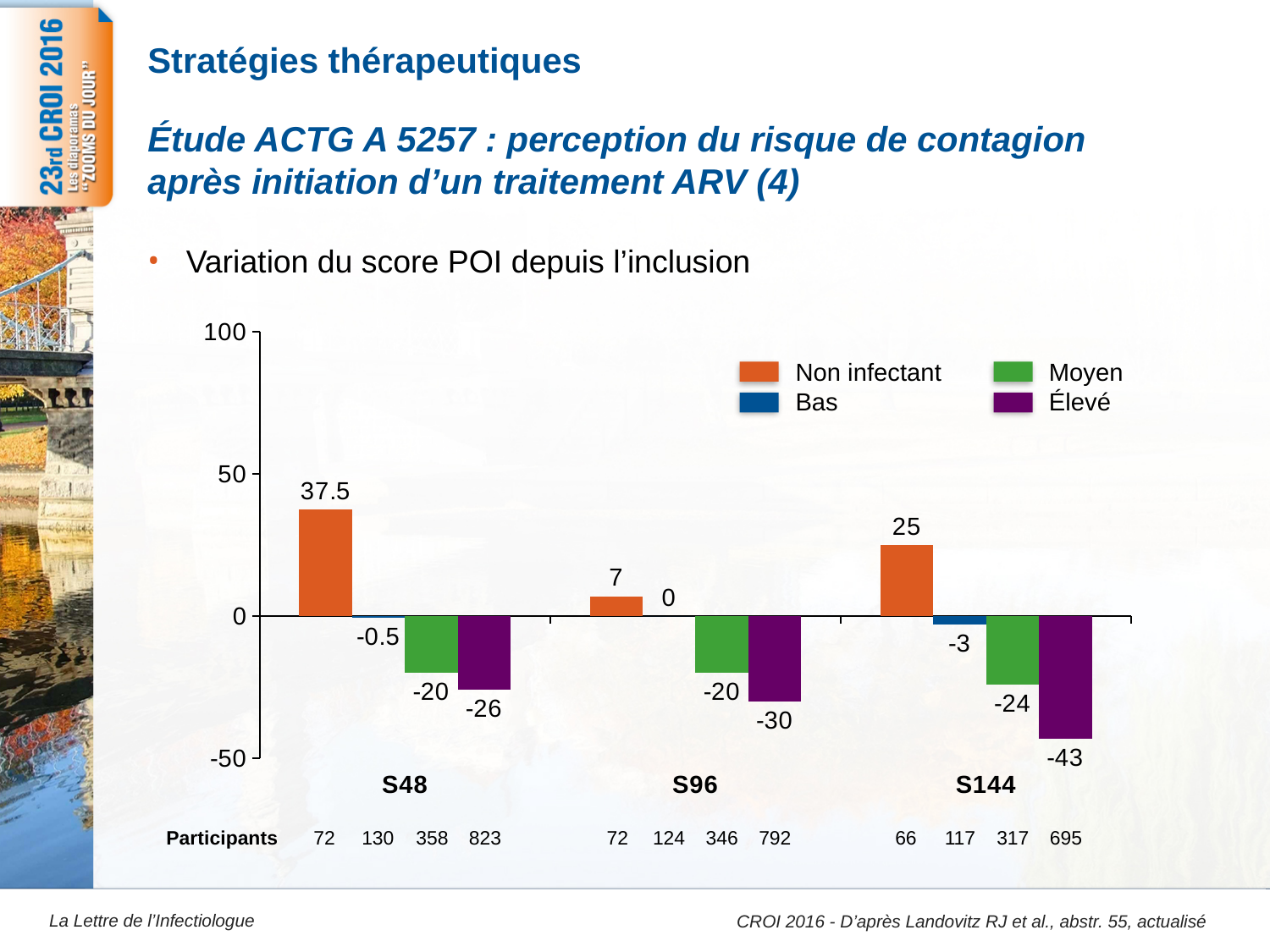
What is the value for Élevé at S144? -43 What is the difference between the Non infectant values at S48 and S144? 12.5 What is the value for Moyen at S144? -24 How many series does the legend list? 4 What kind of chart is shown? Bar chart Which colour represents the Moyen series? Green How many time points are shown on the x axis? 3 At which time point is the Élevé value lowest? S144 What is the value for Non infectant at S48? 37.5 Which is larger: the Élevé value at S48 or at S96? S48 What is the value for Bas at S96? 0 At which time point is the Non infectant value highest? S48